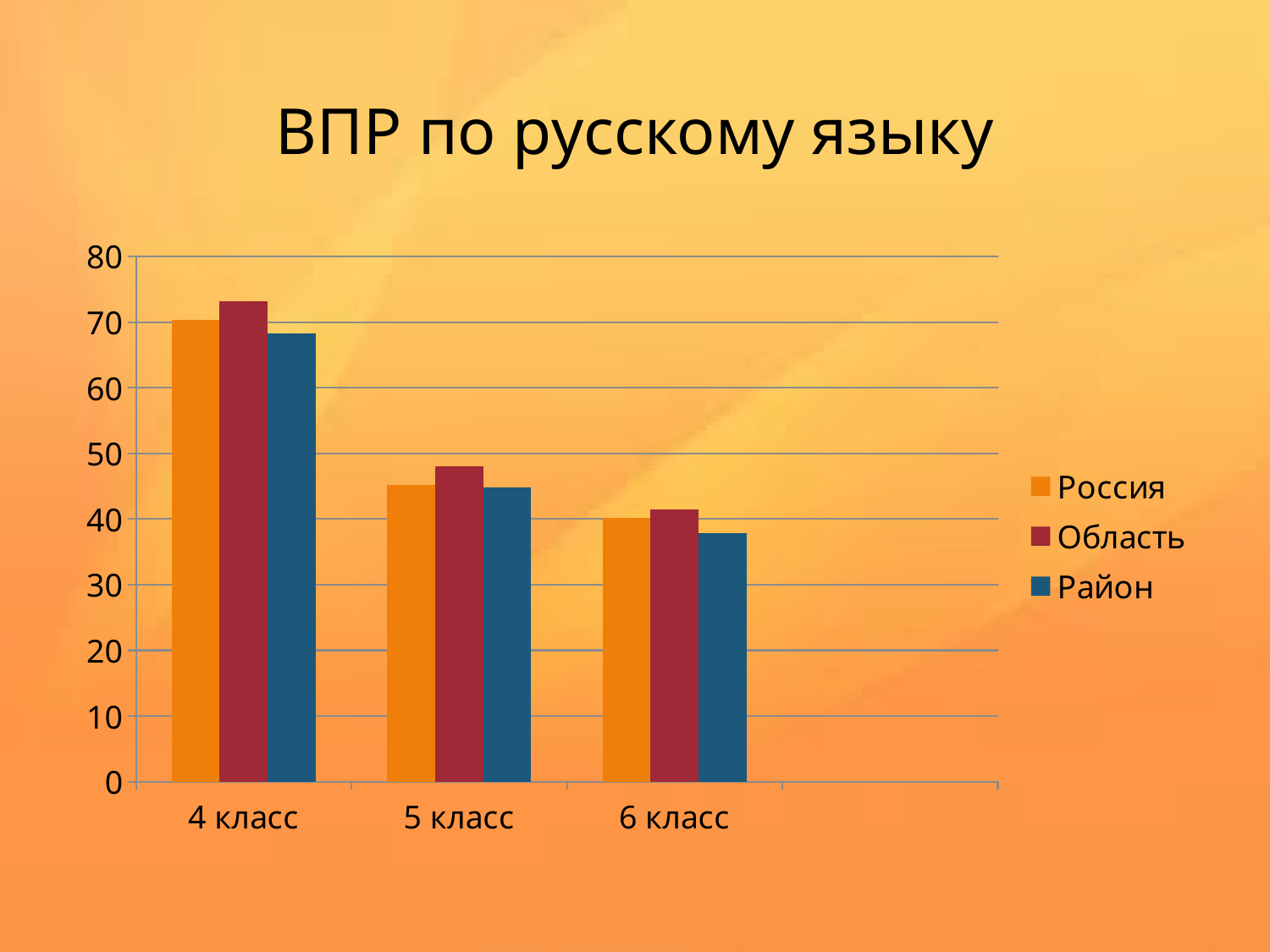
What is the title of the chart? ВПР по русскому языку Is the value for Область in 5 класс greater or less than 50? less Is the value for Район in 6 класс greater or less than 40? less Is the value for Район in 4 класс greater or less than 70? less For 6 класс, which series has the lowest value? Район Do the values for Россия rise or fall from 4 класс to 6 класс? fall Which series is shown in blue in the legend? Район How many categories are shown on the x axis? 3 For 4 класс, which series has the highest value? Область How many series does the legend list? 3 What kind of chart is shown on the slide? bar chart